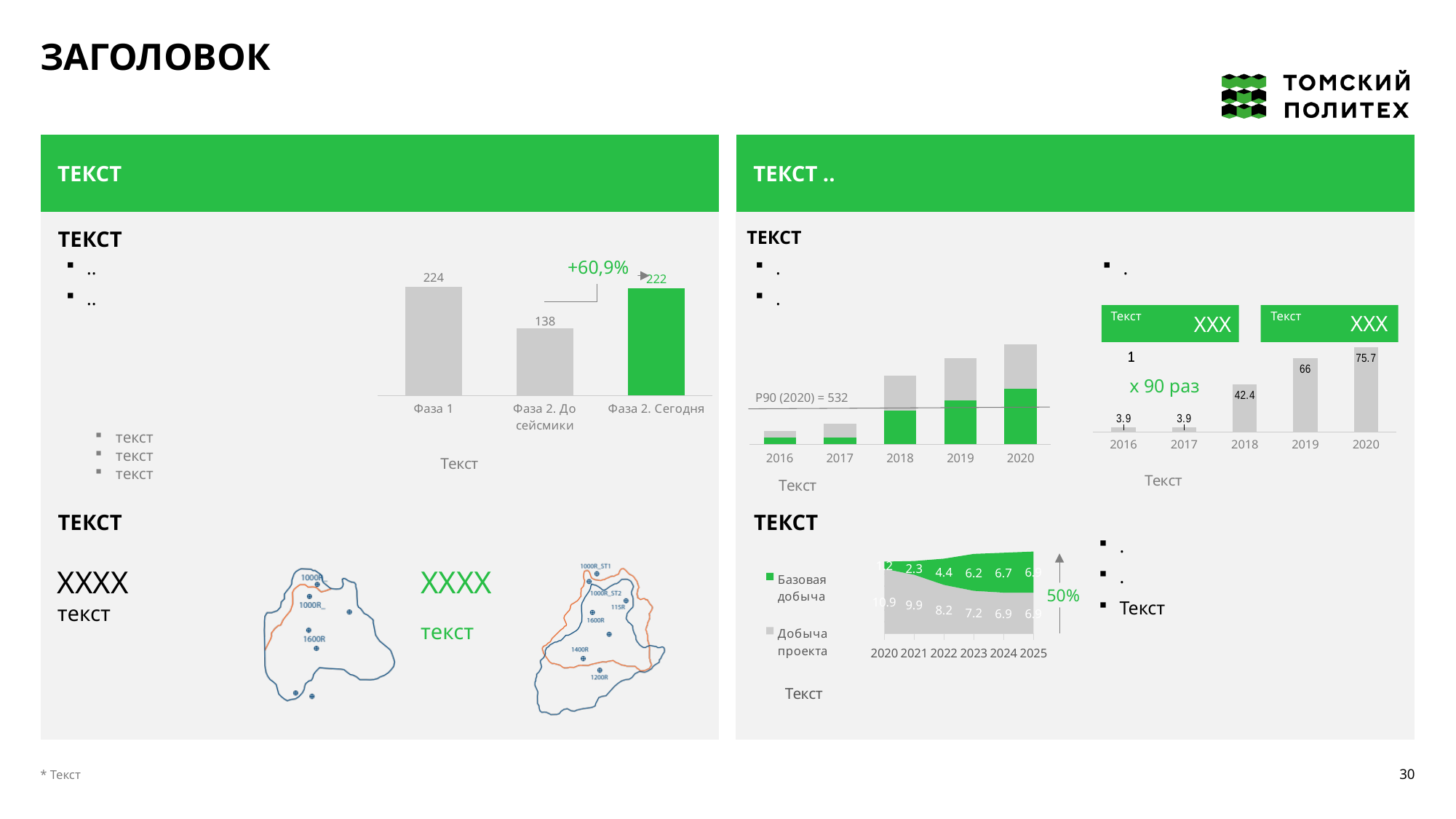
In the bar chart in the left panel, what is the difference between Фаза 1 and Фаза 2. До сейсмики? 86 In the area chart at the bottom of the right panel, what is the value of Добыча проекта for 2020? 10.9 In the area chart at the bottom of the right panel, how many series does the legend list? 2 In the bar chart in the upper right of the right panel (years 2016–2020), what is the value for 2018? 42.4 In the bar chart in the upper right of the right panel (years 2016–2020), which year has the highest value? 2020 In the bar chart in the upper right of the right panel (years 2016–2020), what is the difference between the 2020 and 2019 values? 9.7 In the bar chart in the upper right of the right panel (years 2016–2020), do the values rise or fall from 2016 to 2020? rise In the bar chart in the left panel, which category has the lowest value? Фаза 2. До сейсмики In the bar chart in the left panel, how many categories are shown on the x axis? 3 In the bar chart in the left panel, what percentage change is annotated above the Фаза 2. Сегодня bar? +60,9% In the bar chart in the left panel, what is the value for Фаза 2. До сейсмики? 138 In the bar chart in the left panel, what is the value for Фаза 1? 224